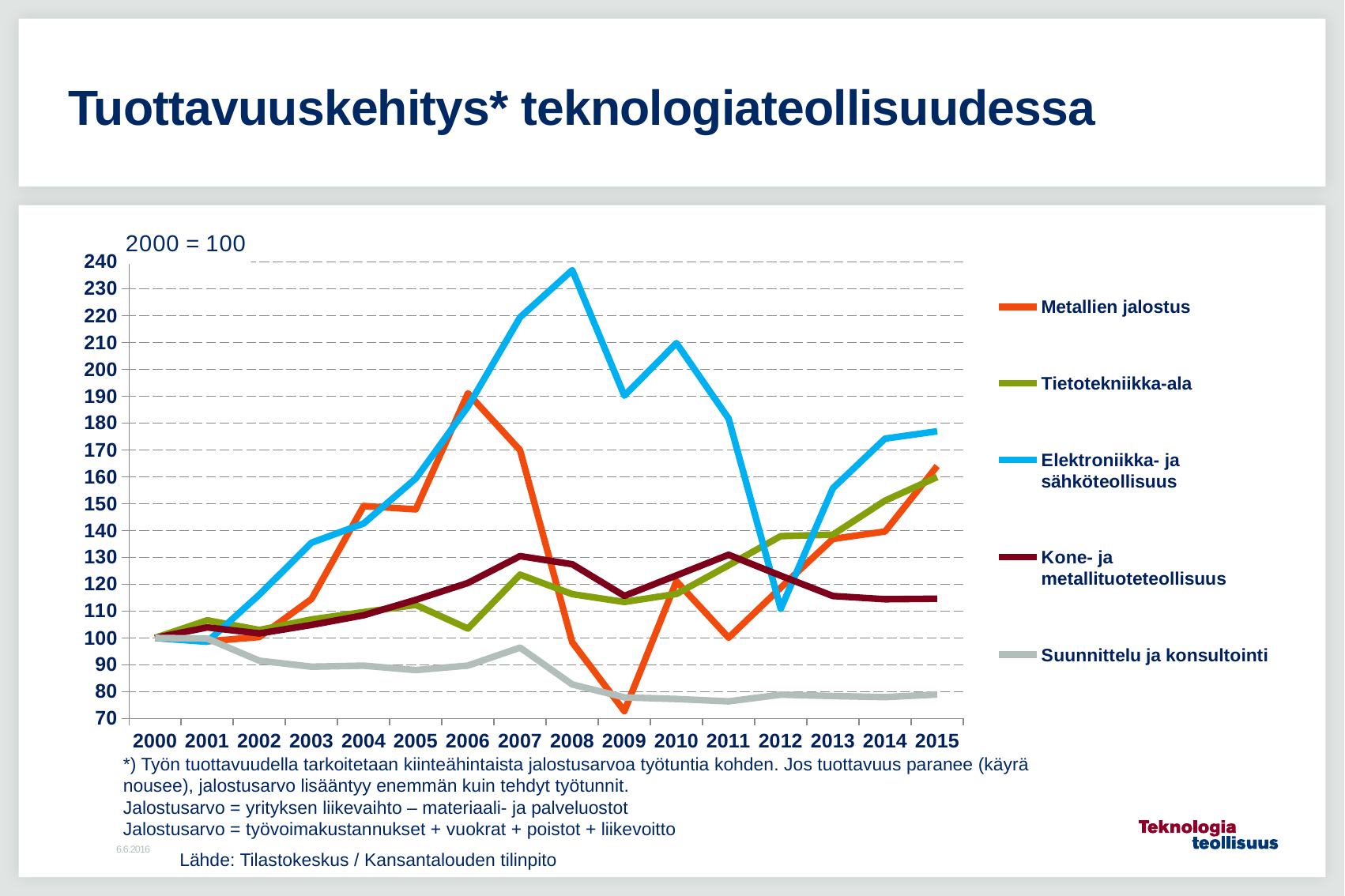
How many series does the legend list? 5 What base index is stated above the chart? 2000 = 100 Is the value for Suunnittelu ja konsultointi in 2015 greater or less than 90? less How many years are shown on the x axis? 16 Which series has the highest value in 2008? Elektroniikka- ja sähköteollisuus Is the value for Metallien jalostus in 2009 greater or less than 80? less Does the Suunnittelu ja konsultointi series rise or fall overall from 2000 to 2015? fall What kind of chart is shown on the slide? line chart Which series has the lowest value in 2015? Suunnittelu ja konsultointi In 2015, which is larger: Elektroniikka- ja sähköteollisuus or Kone- ja metallituoteteollisuus? Elektroniikka- ja sähköteollisuus Is the value for Elektroniikka- ja sähköteollisuus in 2008 greater or less than 230? greater What is the title of the slide containing the chart? Tuottavuuskehitys* teknologiateollisuudessa